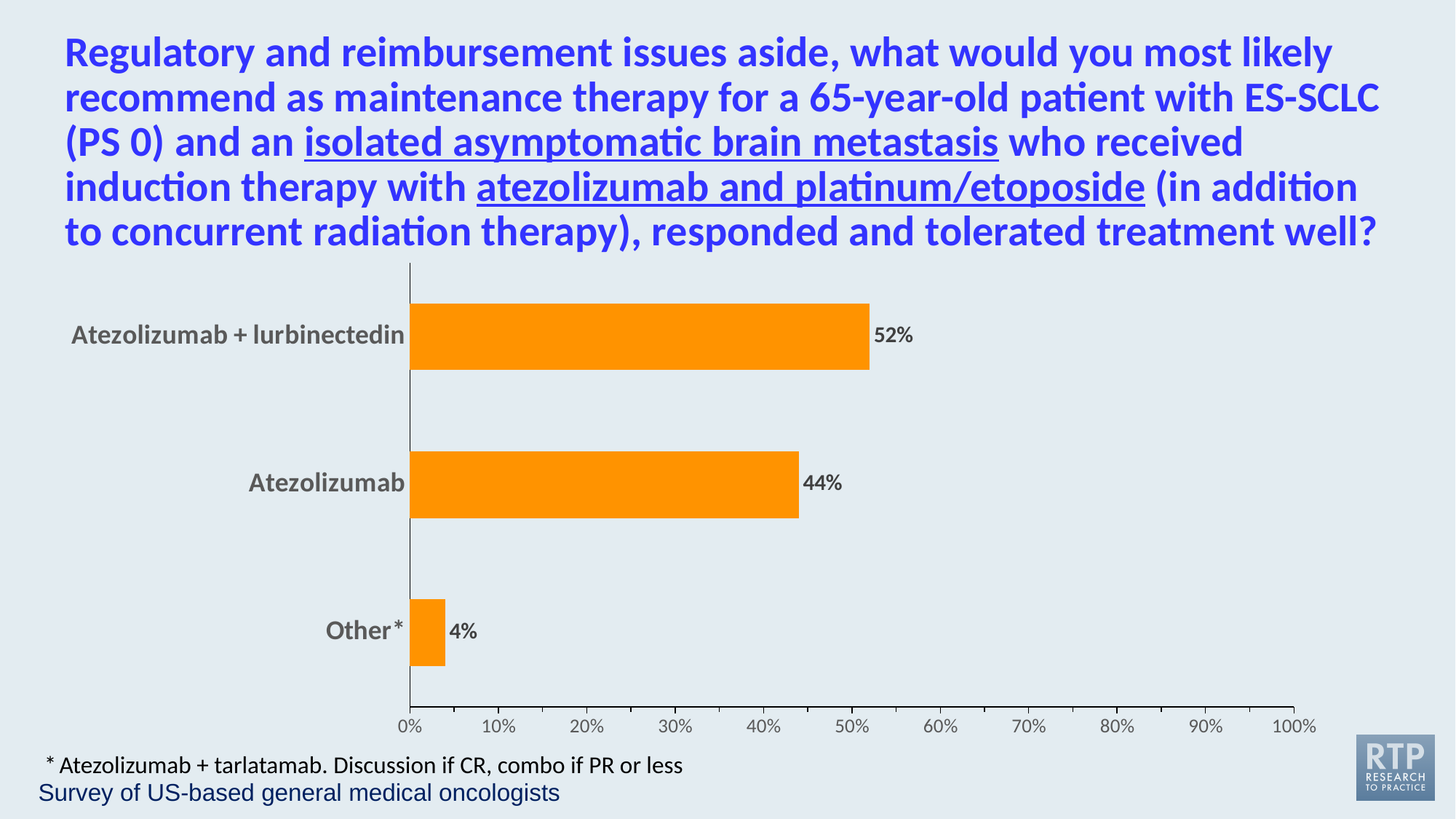
What is the difference in percentage points between Atezolizumab and Other? 40 Is the value for Atezolizumab + lurbinectedin greater or less than 50%? greater What percentage of respondents chose Atezolizumab + lurbinectedin? 52% How many response options are shown in the chart? 3 What percentage of respondents chose Other? 4% What is the maximum value shown on the horizontal axis? 100% What percentage of respondents chose Atezolizumab alone? 44% Which received a larger share of responses, Atezolizumab + lurbinectedin or Atezolizumab? Atezolizumab + lurbinectedin What is the difference in percentage points between Atezolizumab + lurbinectedin and Atezolizumab? 8 Which option received the lowest percentage of responses? Other What type of chart is shown on the slide? Bar chart Which option received the highest percentage of responses? Atezolizumab + lurbinectedin